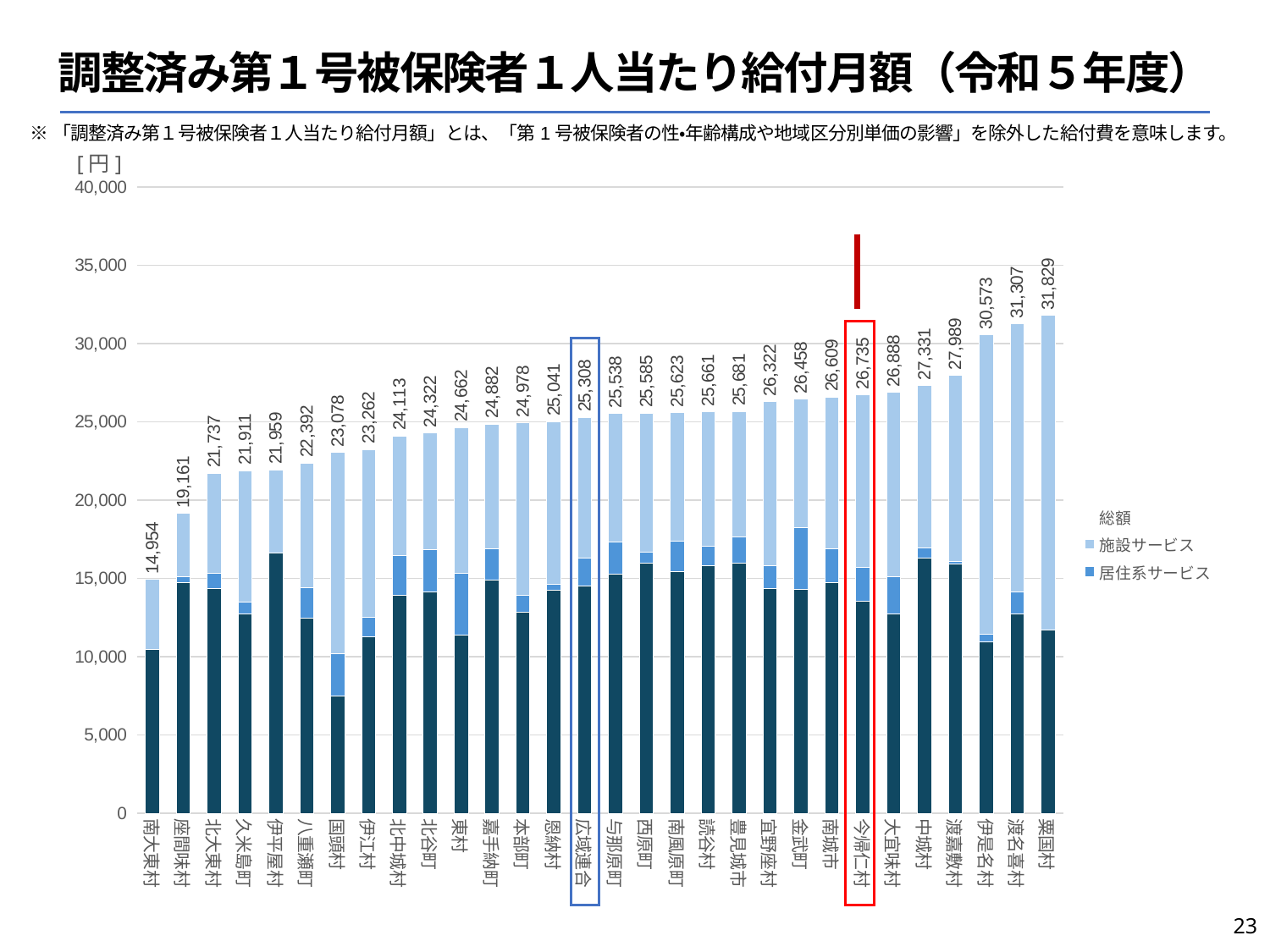
What type of chart is shown on the slide? stacked bar chart What is the difference between the total for 今帰仁村 and the total for 広域連合? 1,427 Which category has the lowest total value? 南大東村 What is the total value shown for 今帰仁村? 26,735 How many categories are shown on the x axis? 30 Is the total value for 伊是名村 greater or less than 30,000? greater Do the total values generally rise or fall from left to right along the x axis? rise What is the difference between the total for 粟国村 and the total for 南大東村? 16,875 Which category has the highest total value? 粟国村 What is the total value shown for 南大東村? 14,954 Which has a larger total, 渡嘉敷村 or 中城村? 渡嘉敷村 What is the total value shown for 広域連合? 25,308